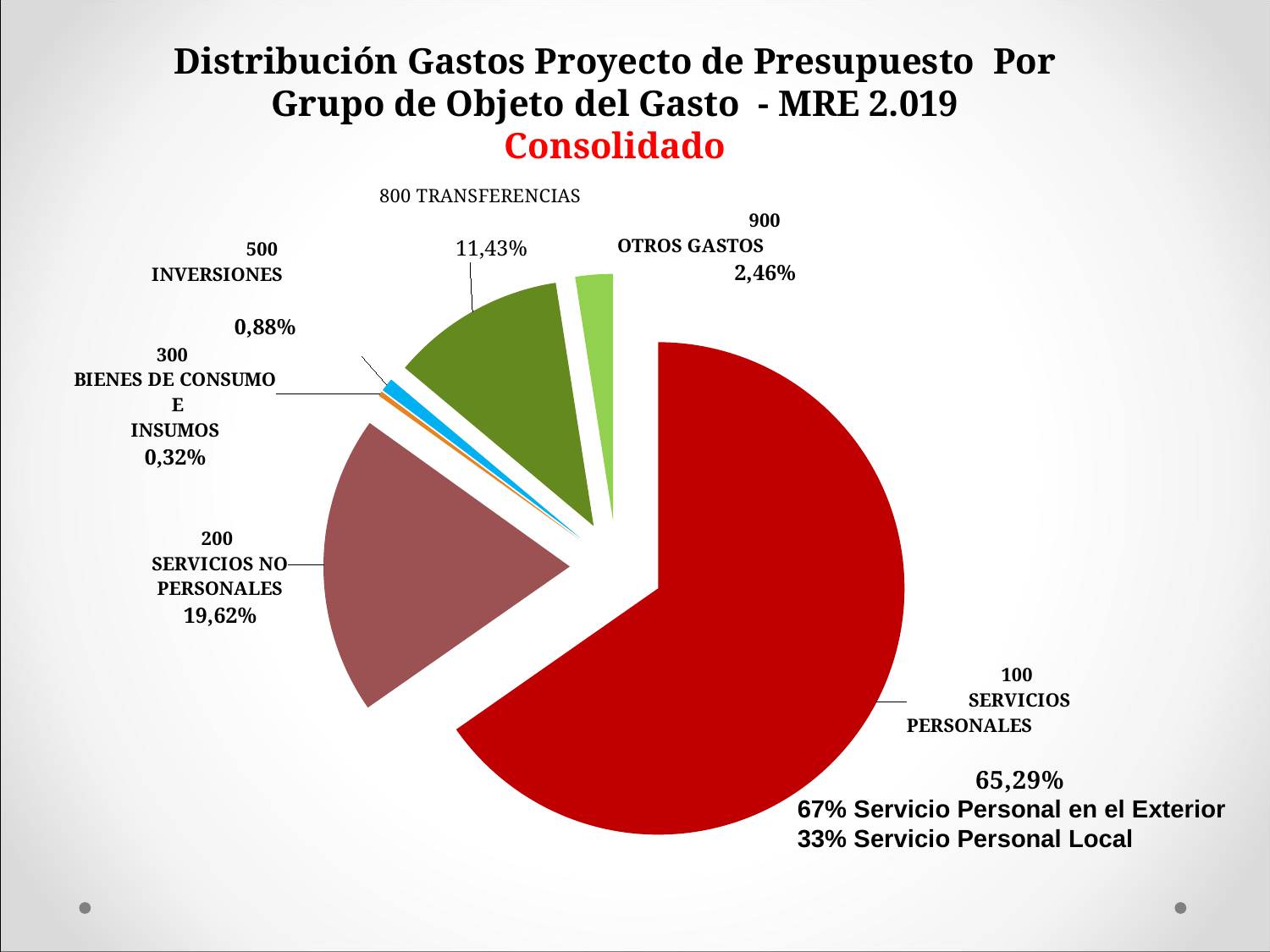
What kind of chart is shown on the slide? Pie chart How many slices does the pie chart have? 6 Which category has the largest slice of the pie? 100 Servicios Personales Which category has the smallest slice of the pie? 300 Bienes de Consumo e Insumos What is the value shown for 900 Otros Gastos? 2,46% What is the difference in percentage points between 200 Servicios No Personales and 800 Transferencias? 8,19 What is the value shown for 200 Servicios No Personales? 19,62% What is the value shown for 300 Bienes de Consumo e Insumos? 0,32% What is the value shown for 800 Transferencias? 11,43% What is the value shown for 500 Inversiones? 0,88% Which is larger, 900 Otros Gastos or 500 Inversiones? 900 Otros Gastos What share of the pie does 100 Servicios Personales represent? 65,29%